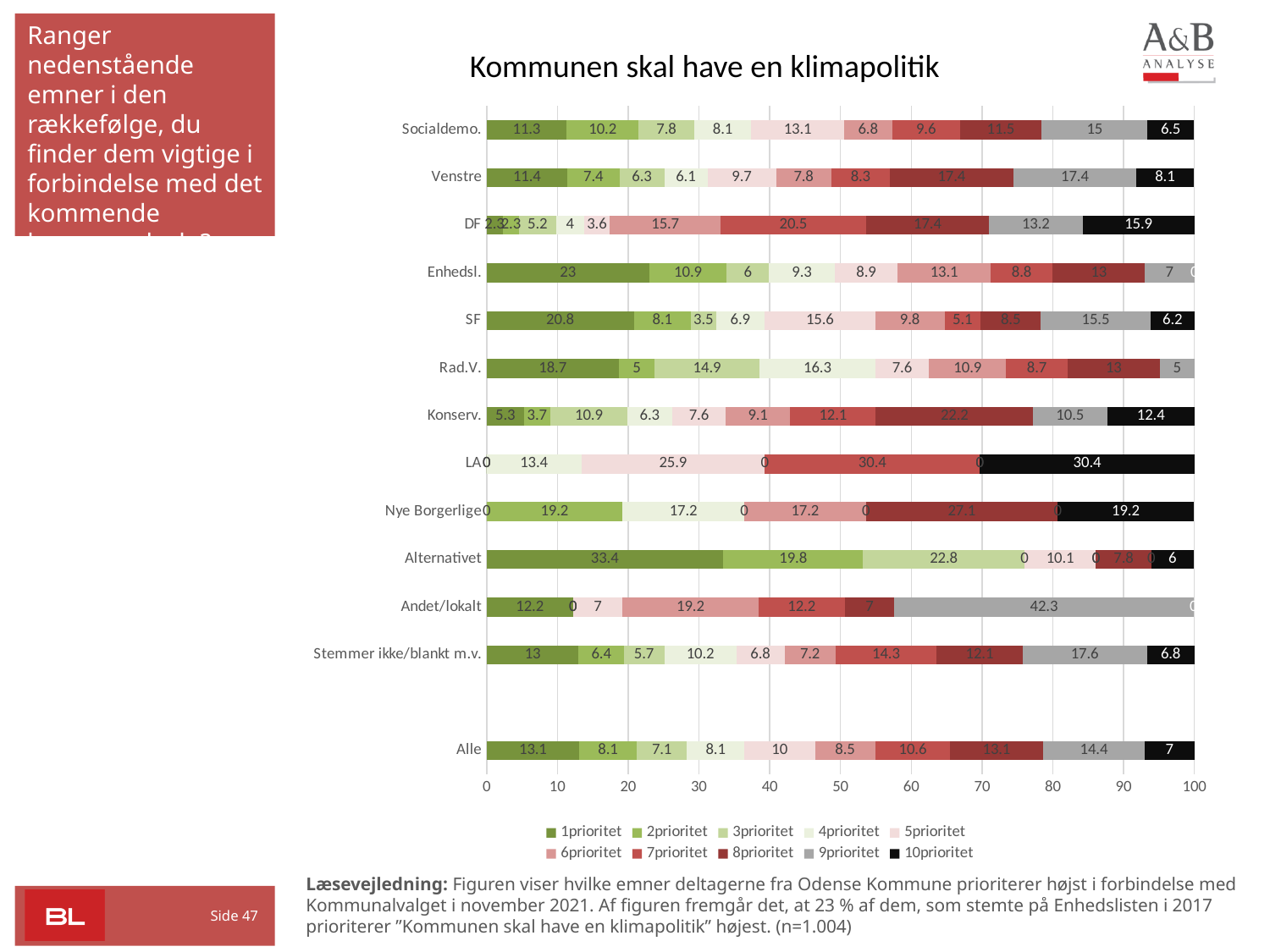
What is the 1prioritet value for Alle? 13.1 What is the 1prioritet value for Enhedsl.? 23 How many categories are shown on the y axis? 13 What is the difference between the 1prioritet values for Alternativet and Enhedsl.? 10.4 What is the 9prioritet value for Andet/lokalt? 42.3 What is the 10prioritet value for LA? 30.4 What kind of chart is shown on the slide? Stacked bar chart Which category has the highest 1prioritet value? Alternativet How many series does the legend list? 10 What is the title of the chart? Kommunen skal have en klimapolitik What is the 1prioritet value for Alternativet? 33.4 Which is larger, the 1prioritet value for SF or for Rad.V.? SF